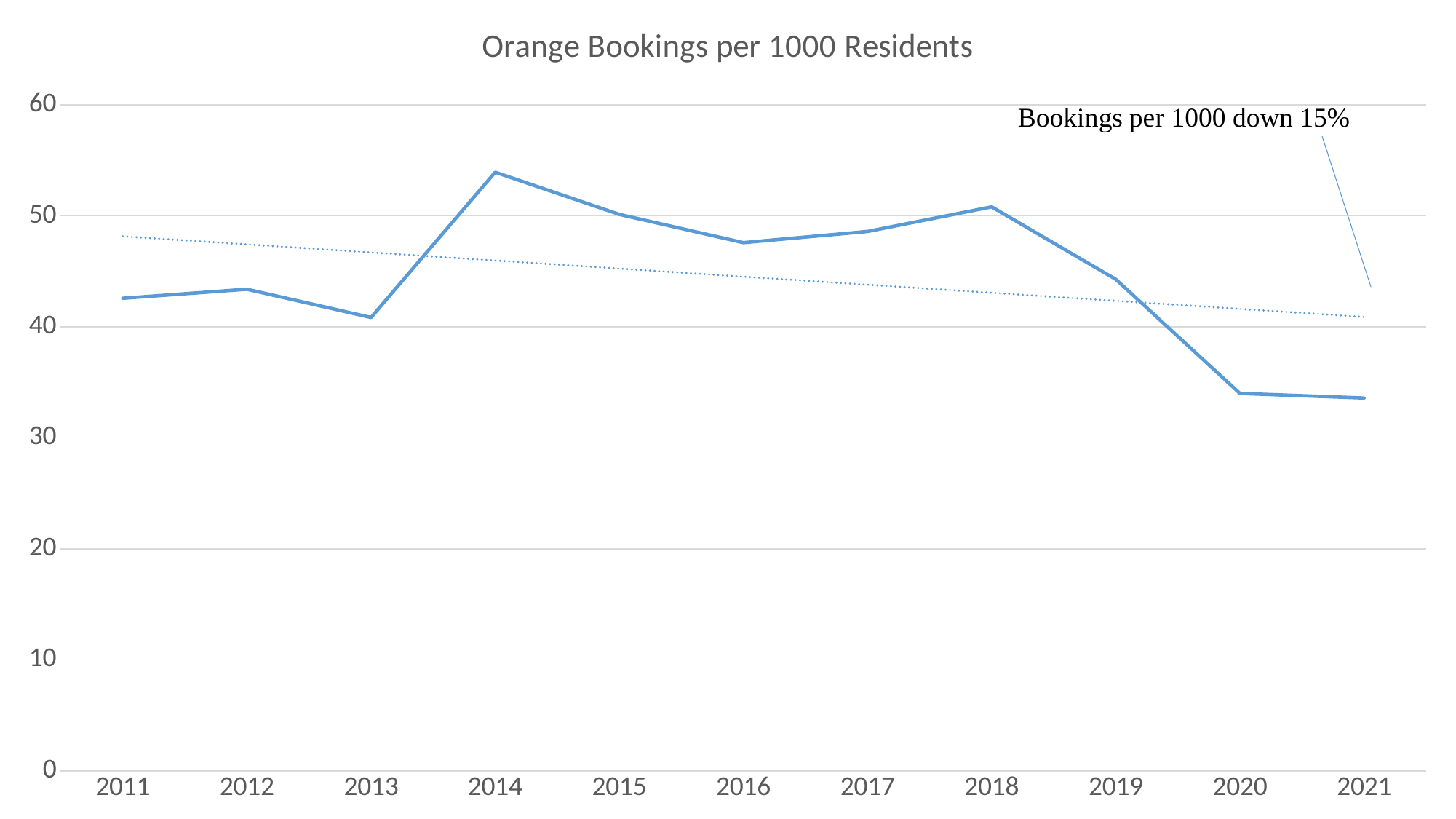
Is the value for 2014 greater or less than 50? greater Which year has the higher value, 2012 or 2013? 2012 Is the value for 2016 greater or less than 50? less What does the annotation text on the chart say? Bookings per 1000 down 15% Is the value for 2020 greater or less than 40? less How many years are plotted along the x axis? 11 Do bookings per 1000 residents rise or fall between 2018 and 2021? fall What is the title of the chart? Orange Bookings per 1000 Residents In which year were bookings per 1000 residents highest? 2014 Which year has the higher value, 2014 or 2018? 2014 What type of chart is shown on the slide? line chart